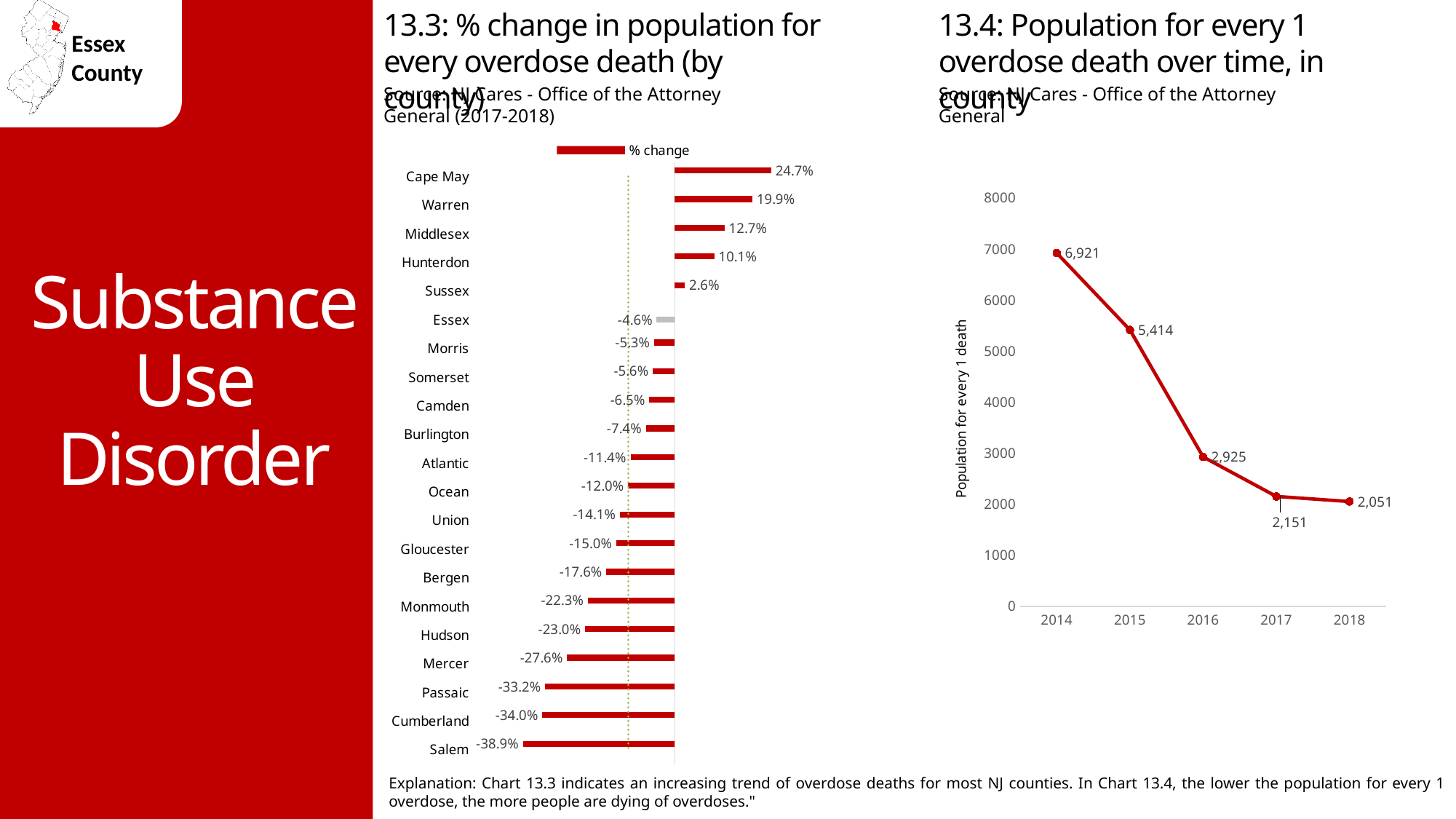
In chart 13.3, what is the % change for Essex? -4.6% In chart 13.3, what is the % change for Cape May? 24.7% In chart 13.3, how many counties are shown? 21 In chart 13.4, what is the population for every 1 overdose death in 2018? 2,051 In chart 13.3, what is the difference between the % change for Warren and Middlesex? 7.2% In chart 13.4, how many years are plotted? 5 What kind of chart is chart 13.3? Bar chart In chart 13.4, what is the population for every 1 overdose death in 2016? 2,925 In chart 13.4, do the values rise or fall from 2014 to 2018? Fall In chart 13.3, which county has the highest % change? Cape May In chart 13.4, what is the difference between the 2014 and 2015 values? 1,507 In chart 13.3, which county has the lowest % change? Salem